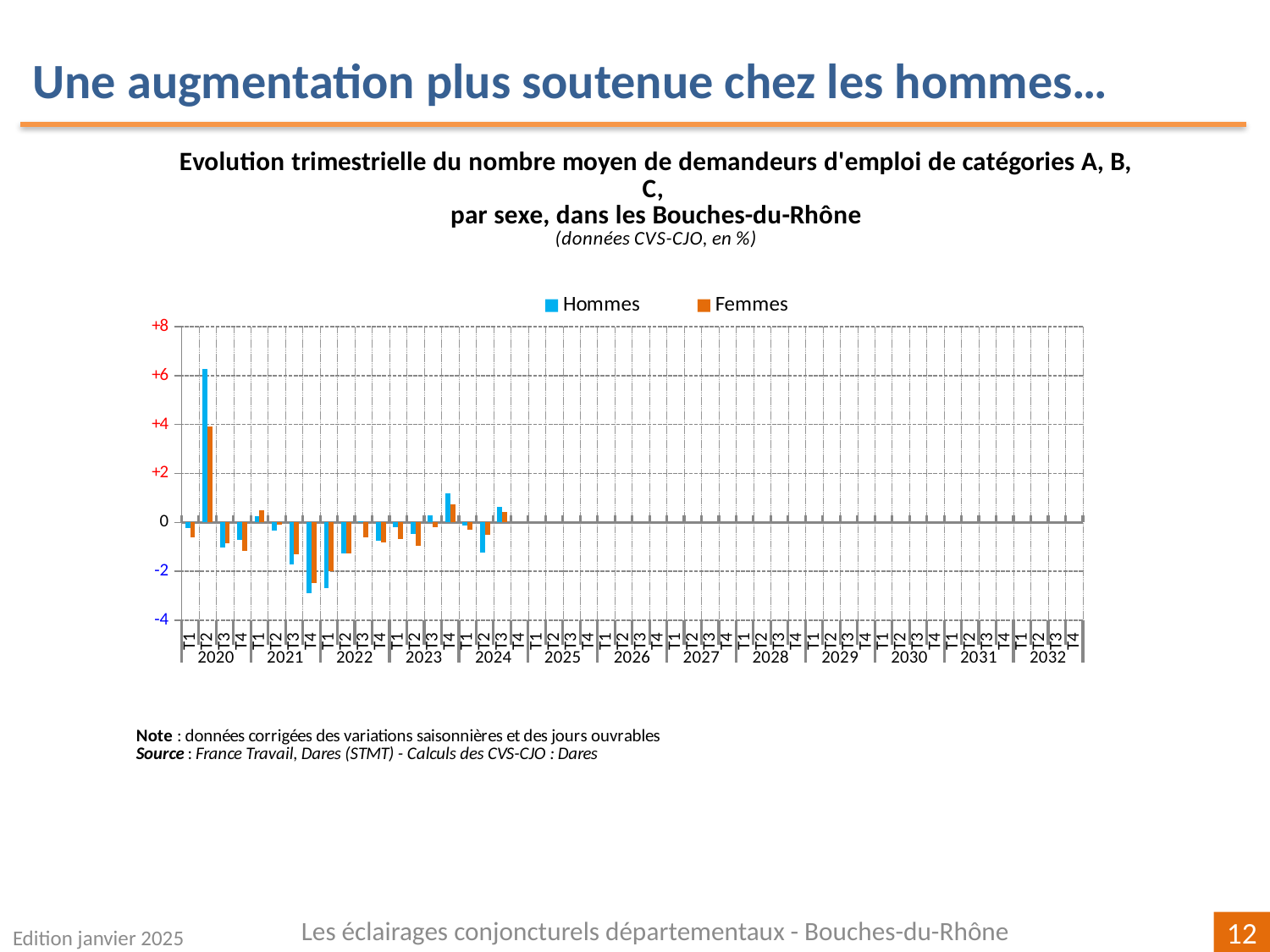
What kind of chart is shown on the slide? bar chart Is the Hommes value for T4 2021 greater or less than -2? less What are the two series named in the legend? Hommes and Femmes Which colour represents the Hommes series? blue Is the Hommes value for T2 2020 greater or less than +4? greater In which quarter does the Femmes series reach its highest value? T2 2020 In T2 2020, which series has the larger value, Hommes or Femmes? Hommes Is the Femmes value for T2 2020 greater or less than +2? greater In which quarter does the Hommes series reach its lowest value? T4 2021 In which quarter does the Hommes series reach its highest value? T2 2020 How many series does the legend list? 2